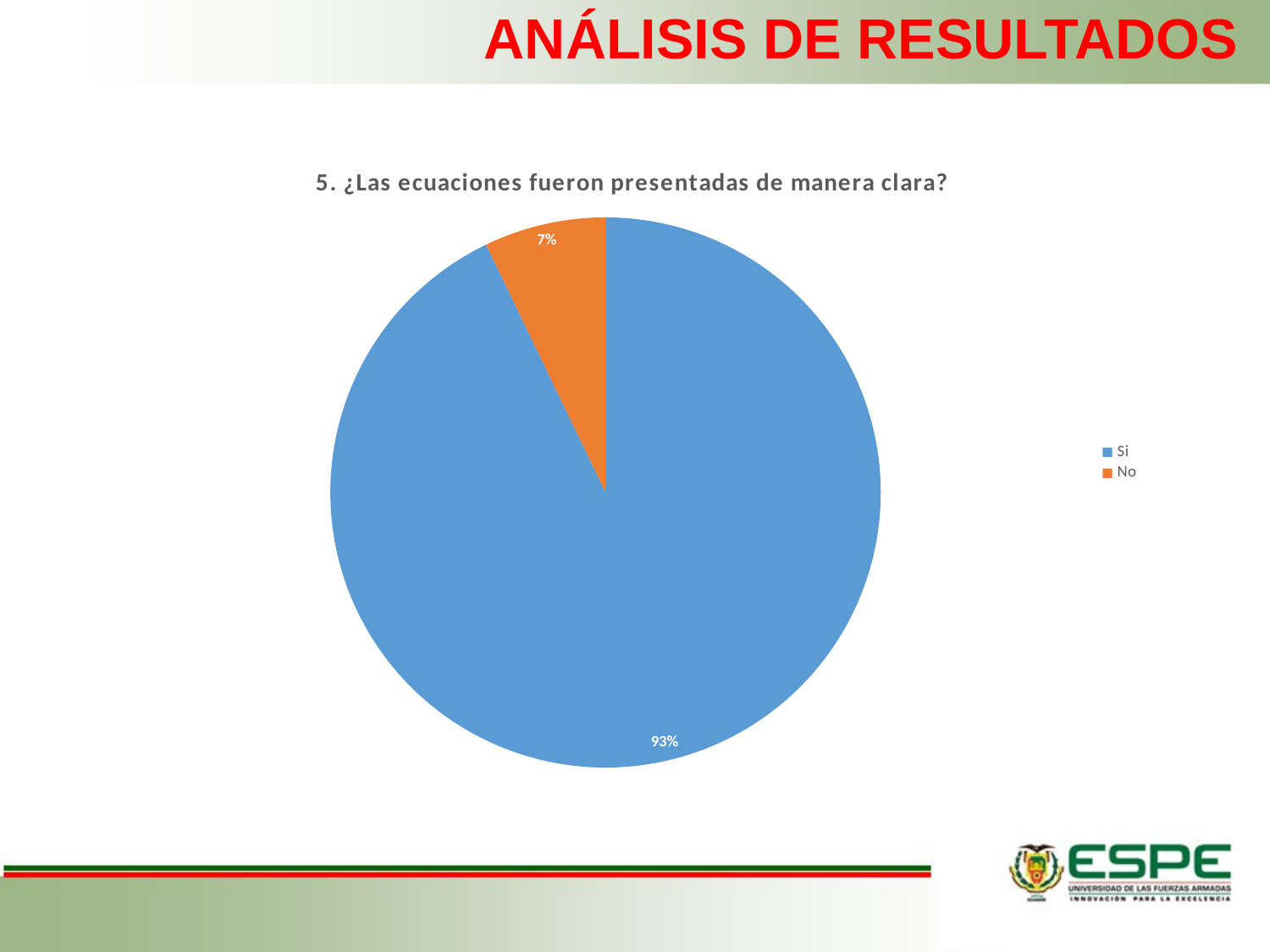
What colour is the "No" slice? orange What percentage of the pie corresponds to "No"? 7% What kind of chart is shown on the slide? pie chart Which category has the smallest share of the pie? No Which category has the largest share of the pie? Si What is the difference in percentage points between the "Si" and "No" slices? 86 What share of the pie does the "Si" slice represent? 93% What percentage of the pie corresponds to "Si"? 93% How many slices does the pie chart have? 2 How many entries does the legend list? 2 What is the title of the chart? 5. ¿Las ecuaciones fueron presentadas de manera clara? Which slice is larger, "Si" or "No"? Si